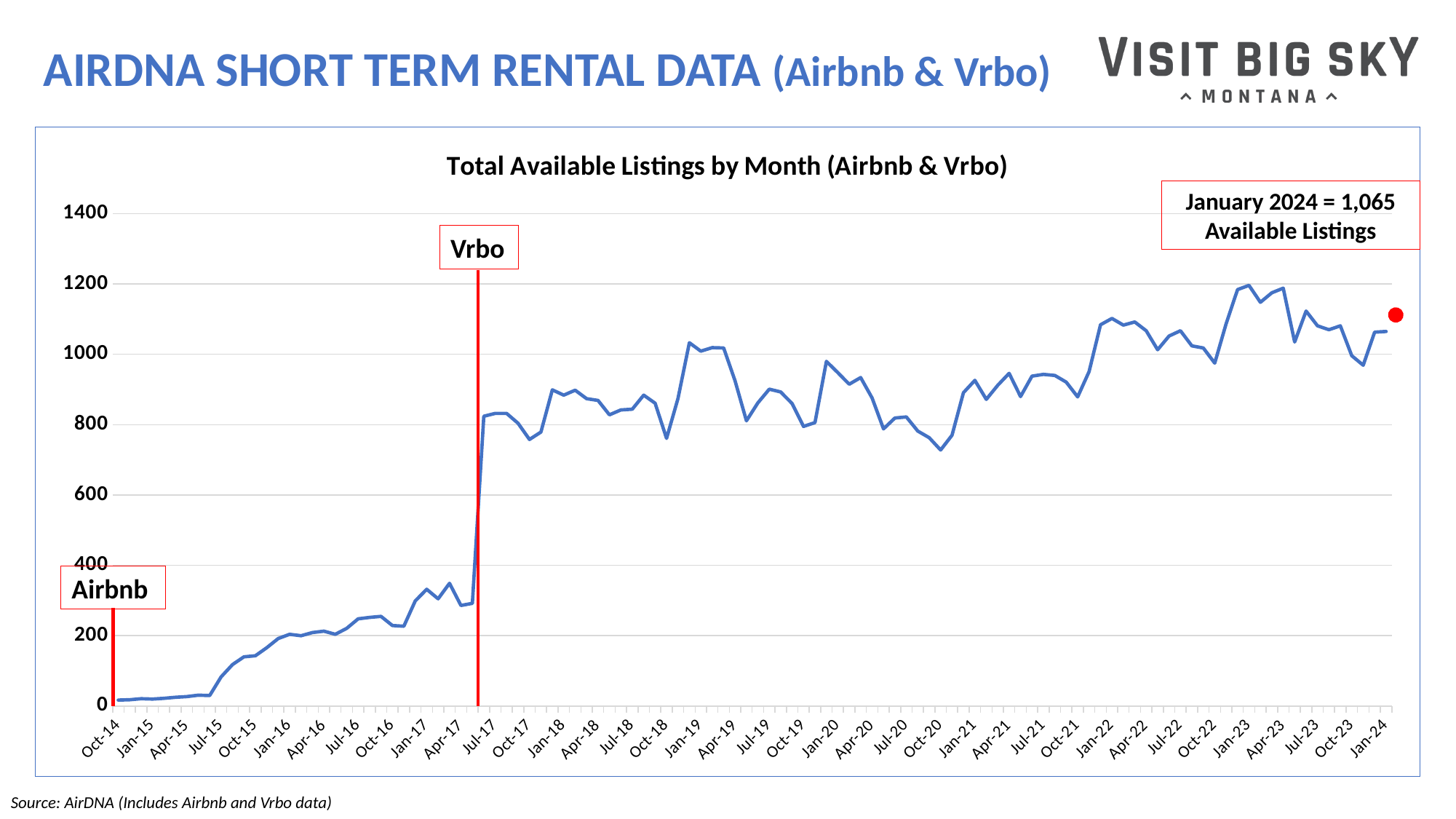
What kind of chart is shown on the slide? line chart Is the value for Oct-20 greater or less than 800? less Overall, do the available listings rise or fall from Oct-14 to Jan-24? rise Is the value for Jan-23 greater or less than 1000? greater How many available listings does the chart annotation give for January 2024? 1,065 Which platform is labelled at the red vertical line near Jul-17 where the line jumps sharply? Vrbo Is the value for Jul-17 greater or less than 800? greater Which is larger, the value for Jan-19 or the value for Oct-20? Jan-19 What is the title of the chart? Total Available Listings by Month (Airbnb & Vrbo)